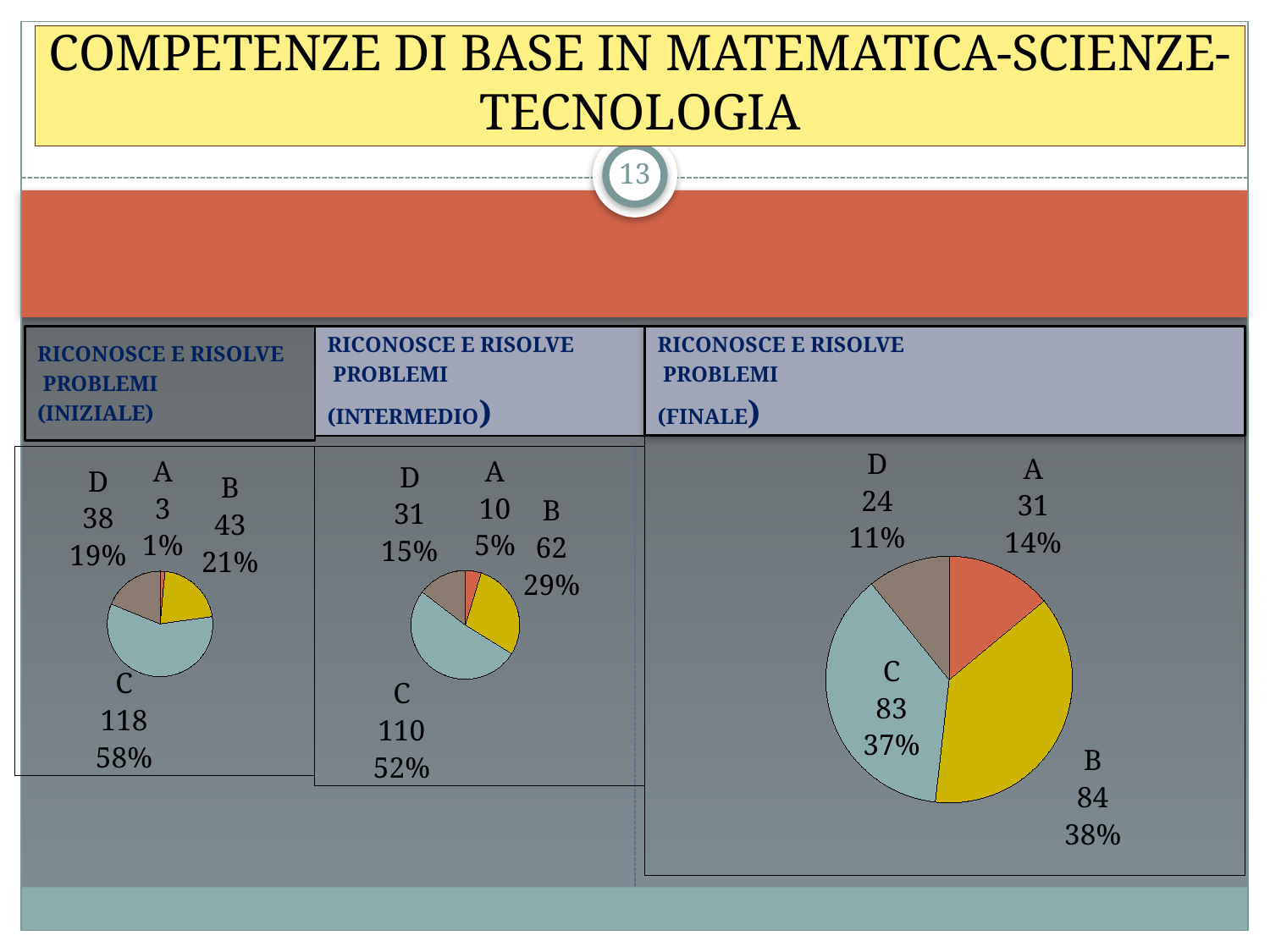
In the INTERMEDIO pie chart, what is the value for category D? 31 In the INIZIALE pie chart, what share of the pie does category B represent? 21% In the FINALE pie chart, what is the difference between the values for B and C? 1 What kind of chart is used in the RICONOSCE E RISOLVE PROBLEMI (INIZIALE) panel? pie chart In the INIZIALE pie chart, what is the value for category C? 118 In the INIZIALE pie chart, which category has the lowest value? A In the FINALE pie chart, what is the value for category A? 31 How many categories does each pie chart on the slide show? 4 In the FINALE pie chart, which is larger, the value for B or the value for D? B In the INTERMEDIO pie chart, what is the difference between the values for C and B? 48 In the INTERMEDIO pie chart, what percentage is shown for category A? 5% In the INTERMEDIO pie chart, which category has the highest value? C